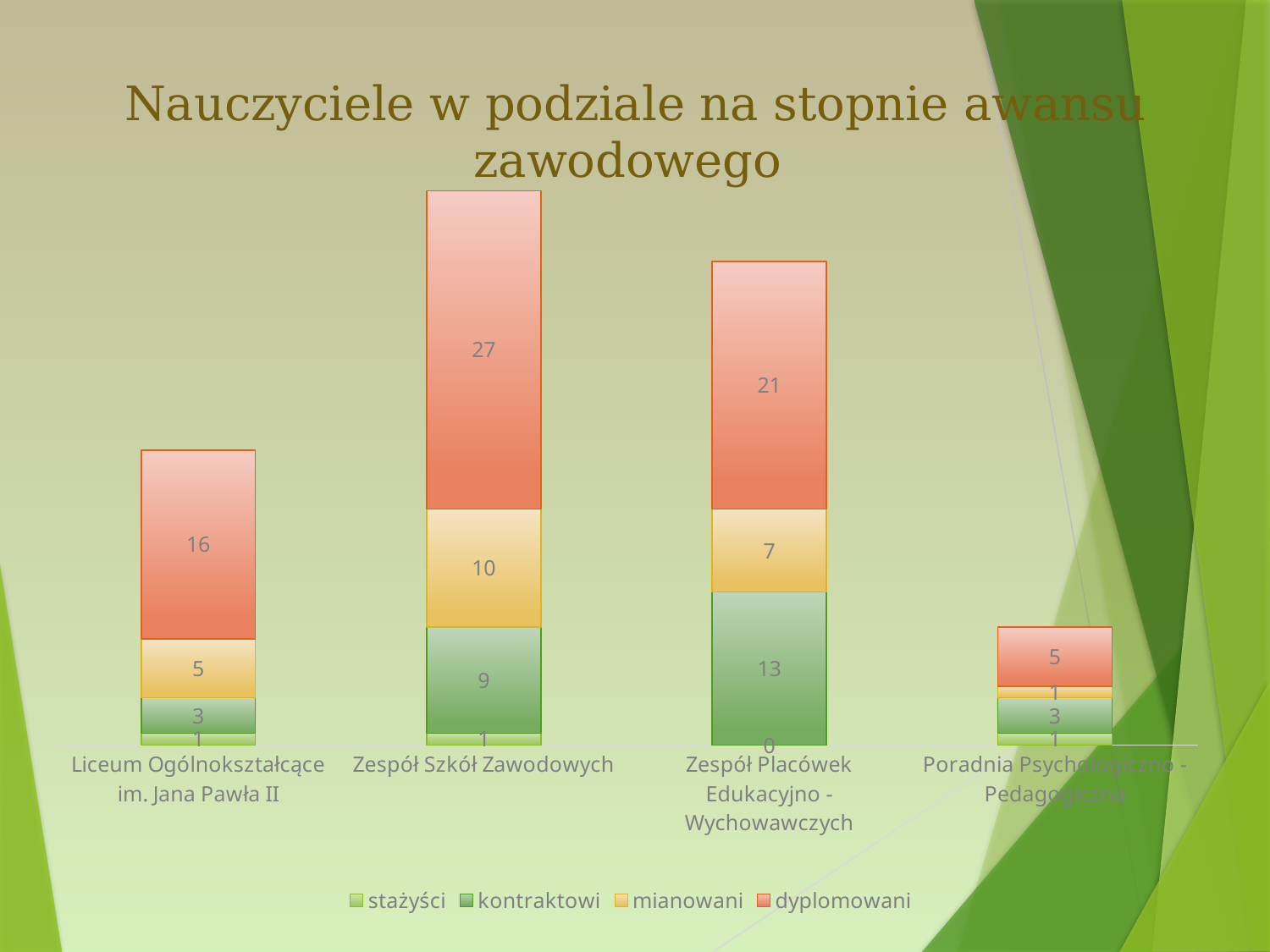
What is the difference between the dyplomowani values for Zespół Szkół Zawodowych and Zespół Placówek Edukacyjno - Wychowawczych? 6 What type of chart is shown on the slide? stacked bar chart What is the title of the chart? Nauczyciele w podziale na stopnie awansu zawodowego Which is larger: kontraktowi at Zespół Szkół Zawodowych or kontraktowi at Zespół Placówek Edukacyjno - Wychowawczych? Zespół Placówek Edukacyjno - Wychowawczych What is the value for dyplomowani at Zespół Szkół Zawodowych? 27 How many series does the legend list? 4 What is the total of the stacked bar for Liceum Ogólnokształcące im. Jana Pawła II? 25 What is the value for kontraktowi at Zespół Placówek Edukacyjno - Wychowawczych? 13 How many categories (institutions) are shown on the x axis? 4 Which institution has the lowest value for stażyści? Zespół Placówek Edukacyjno - Wychowawczych What is the value for mianowani at Liceum Ogólnokształcące im. Jana Pawła II? 5 Which institution has the highest value for dyplomowani? Zespół Szkół Zawodowych